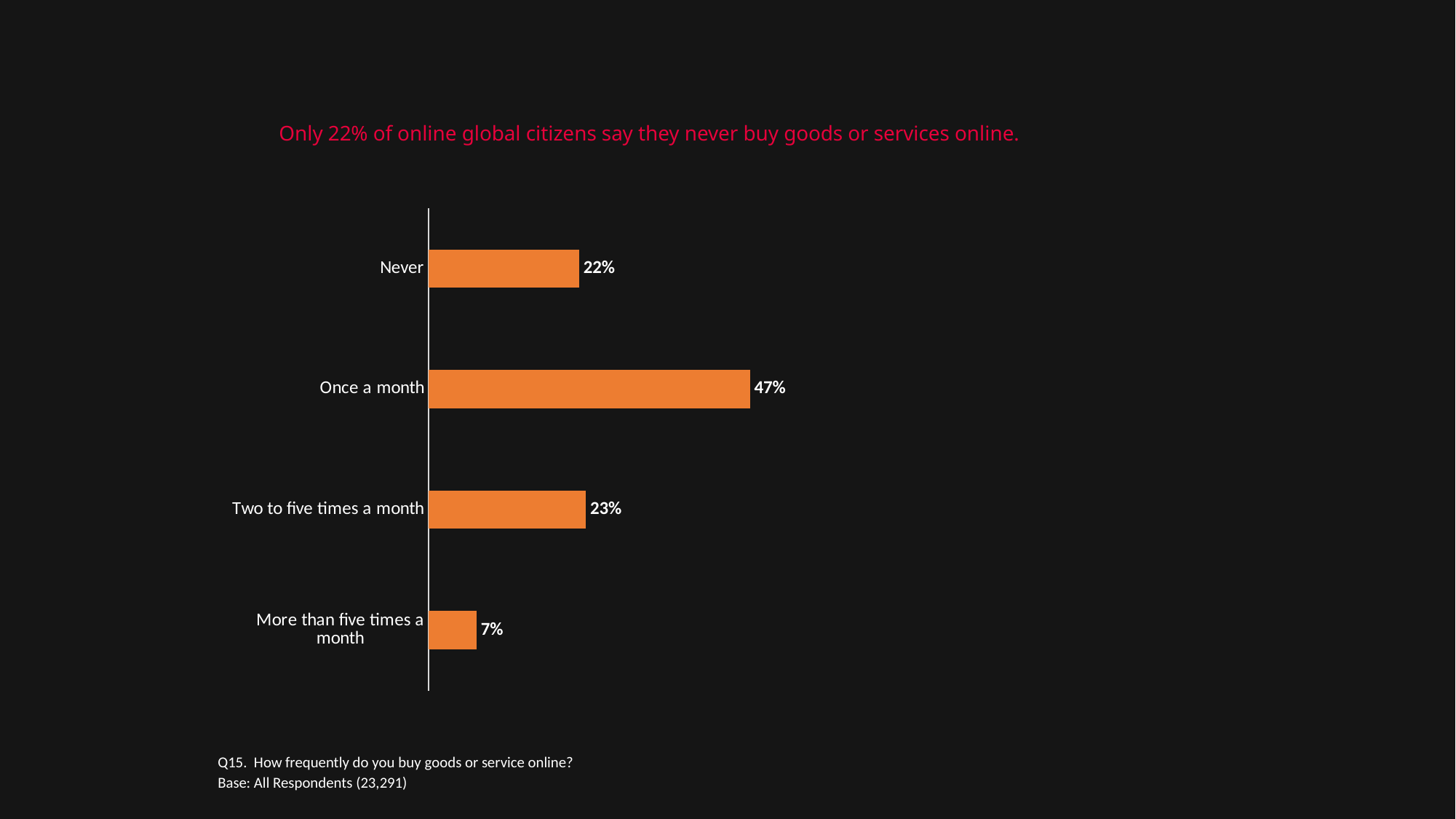
What is the difference between the values for 'Once a month' and 'Never'? 25% What kind of chart is shown on the slide? Bar chart Which category has the highest value? Once a month What is the value for 'More than five times a month'? 7% What is the difference between 'Two to five times a month' and 'More than five times a month'? 16% Which is larger, the value for 'Once a month' or the value for 'Two to five times a month'? Once a month What is the value for 'Two to five times a month'? 23% What is the value for 'Once a month'? 47% How many categories are shown in the chart? 4 What percentage of respondents say they never buy goods or services online? 22% Which category has the lowest value? More than five times a month What is the survey question referenced below the chart? Q15. How frequently do you buy goods or service online?